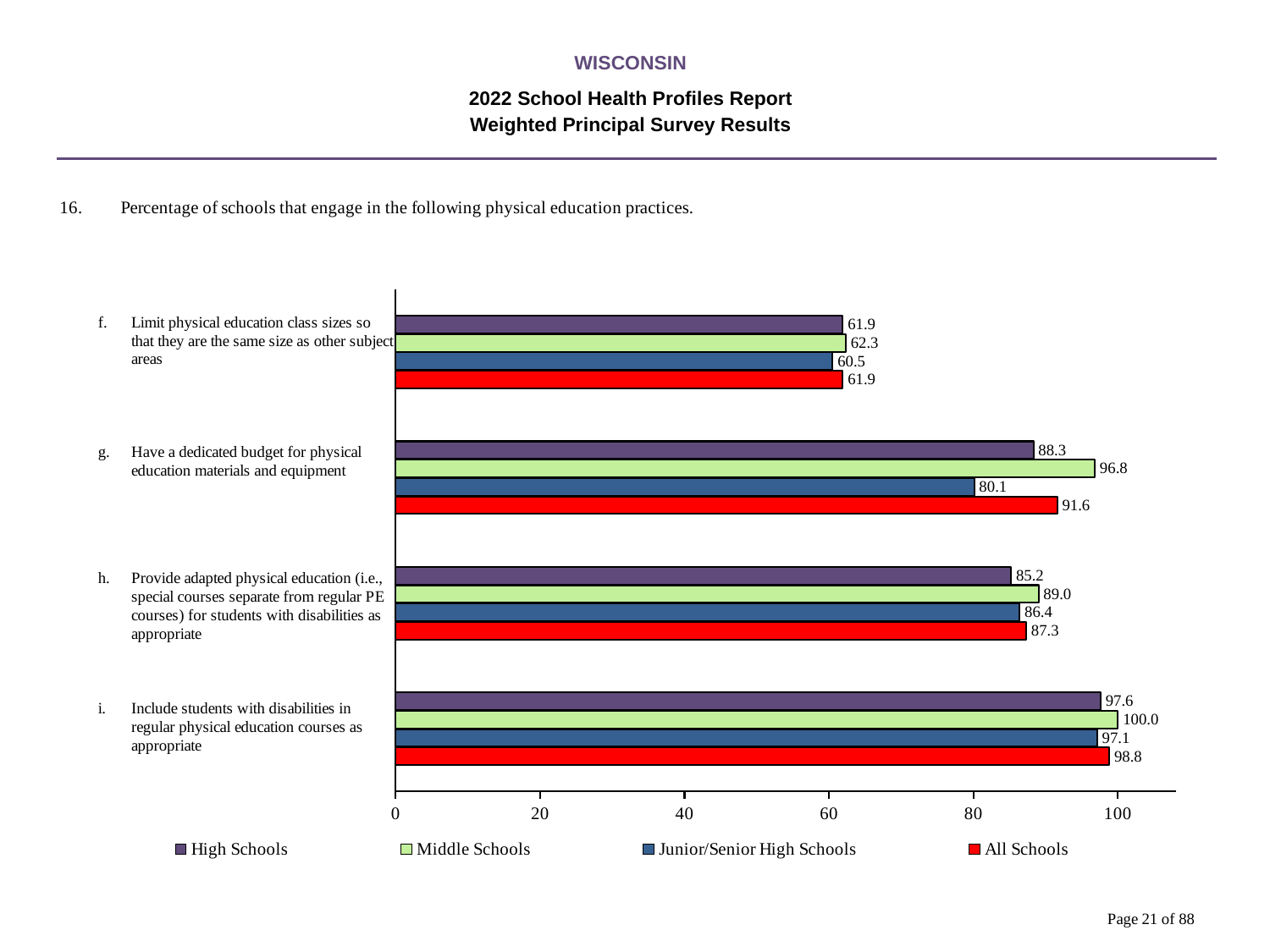
How many series does the legend list? 4 What kind of chart is shown on the slide? bar chart What percentage of Junior/Senior High Schools limit physical education class sizes so that they are the same size as other subject areas? 60.5 What is the All Schools value for including students with disabilities in regular physical education courses as appropriate? 98.8 Is the High Schools value for limiting physical education class sizes greater or less than 80? less How many physical education practices are shown on the chart? 4 Which series is shown in red in the legend? All Schools What is the difference between the Middle Schools and Junior/Senior High Schools values for having a dedicated budget for physical education materials and equipment? 16.7 Which school type has the lowest value for providing adapted physical education for students with disabilities as appropriate? High Schools Which school type has the highest value for having a dedicated budget for physical education materials and equipment? Middle Schools Which is larger for providing adapted physical education: the Middle Schools value or the All Schools value? Middle Schools What percentage of Middle Schools have a dedicated budget for physical education materials and equipment? 96.8